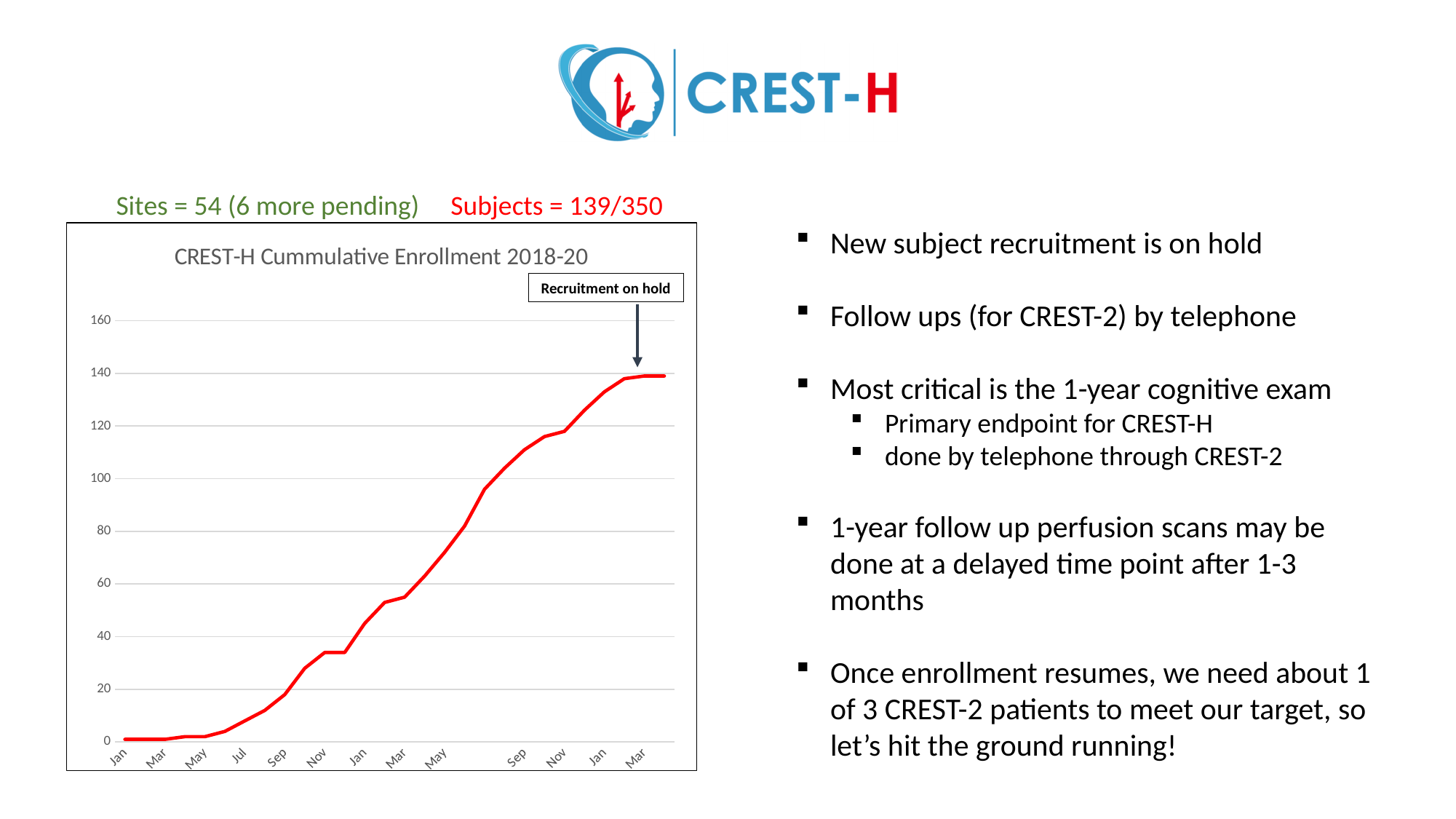
Do the values in the chart rise or fall along the x axis from Jan 2018 to Mar 2020? rise Is the value for Sep 2019 greater or less than 100? greater Is the value for May 2019 greater or less than 80? less Is the value for Jan 2019 greater or less than 40? greater What is the title of the chart? CREST-H Cummulative Enrollment 2018-20 What does the annotation with the arrow near the end of the line say? Recruitment on hold Which of the two values is larger, Mar 2019 or Nov 2019? Nov 2019 What kind of chart is shown on the slide? line chart